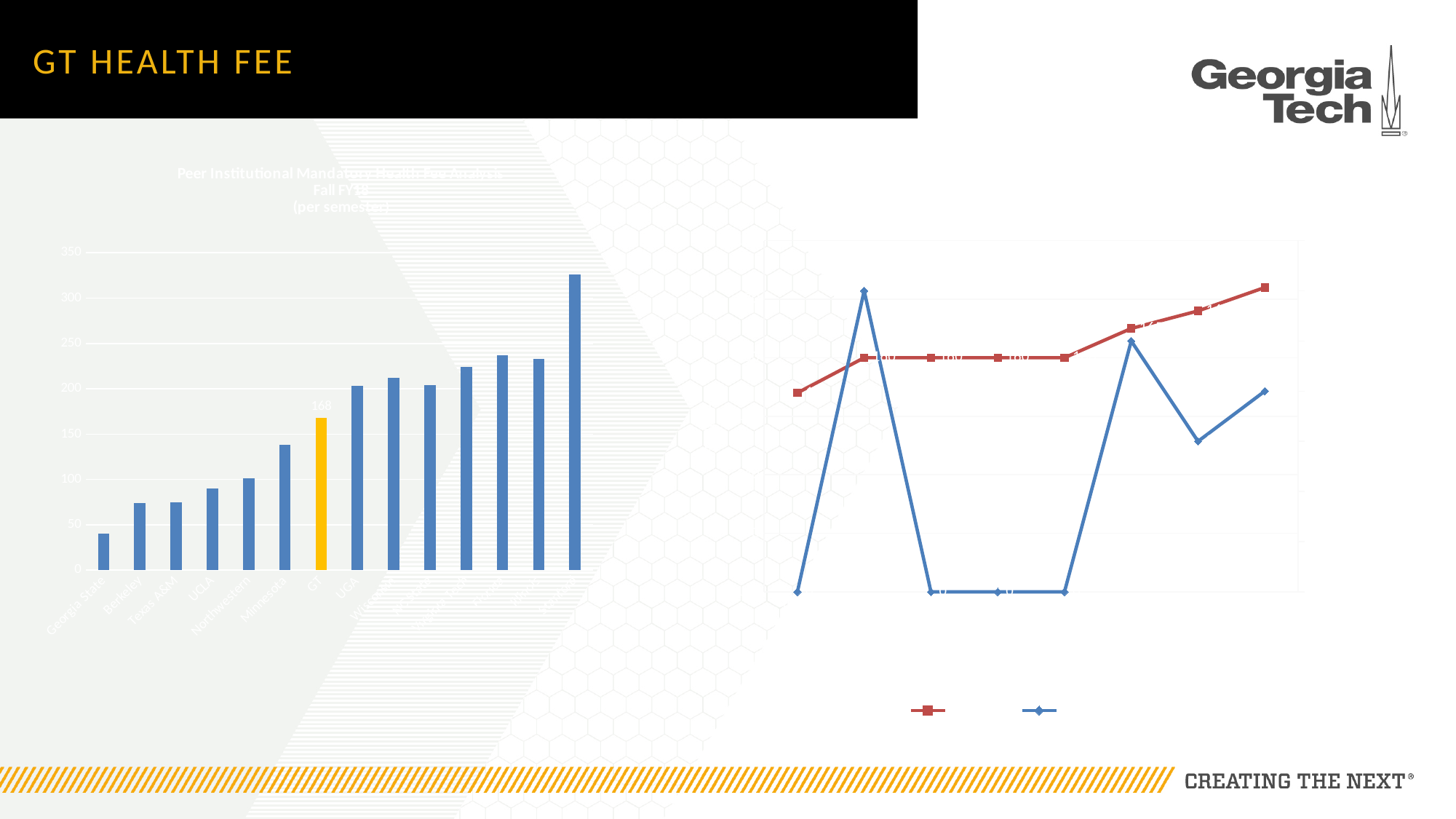
In the bar chart on the left, which is larger, the value for Berkeley or the value for Minnesota? Minnesota What kind of chart is on the left side of the slide? bar chart In the bar chart on the left, which is larger, the value for GT or the value for UGA? UGA How many bars are shown in the bar chart on the left? 14 In the bar chart on the left, is the value for Georgia State greater or less than 50? less How many series does the legend of the chart on the right list? 2 In the bar chart on the left, is the value for Berkeley greater or less than 50? greater In the bar chart on the left, do the values generally rise or fall from left to right? rise In the bar chart on the left, which institution has the lowest health fee? Georgia State In the bar chart on the left, is the value for Minnesota greater or less than 150? less In the bar chart on the left, what is the value for GT? 168